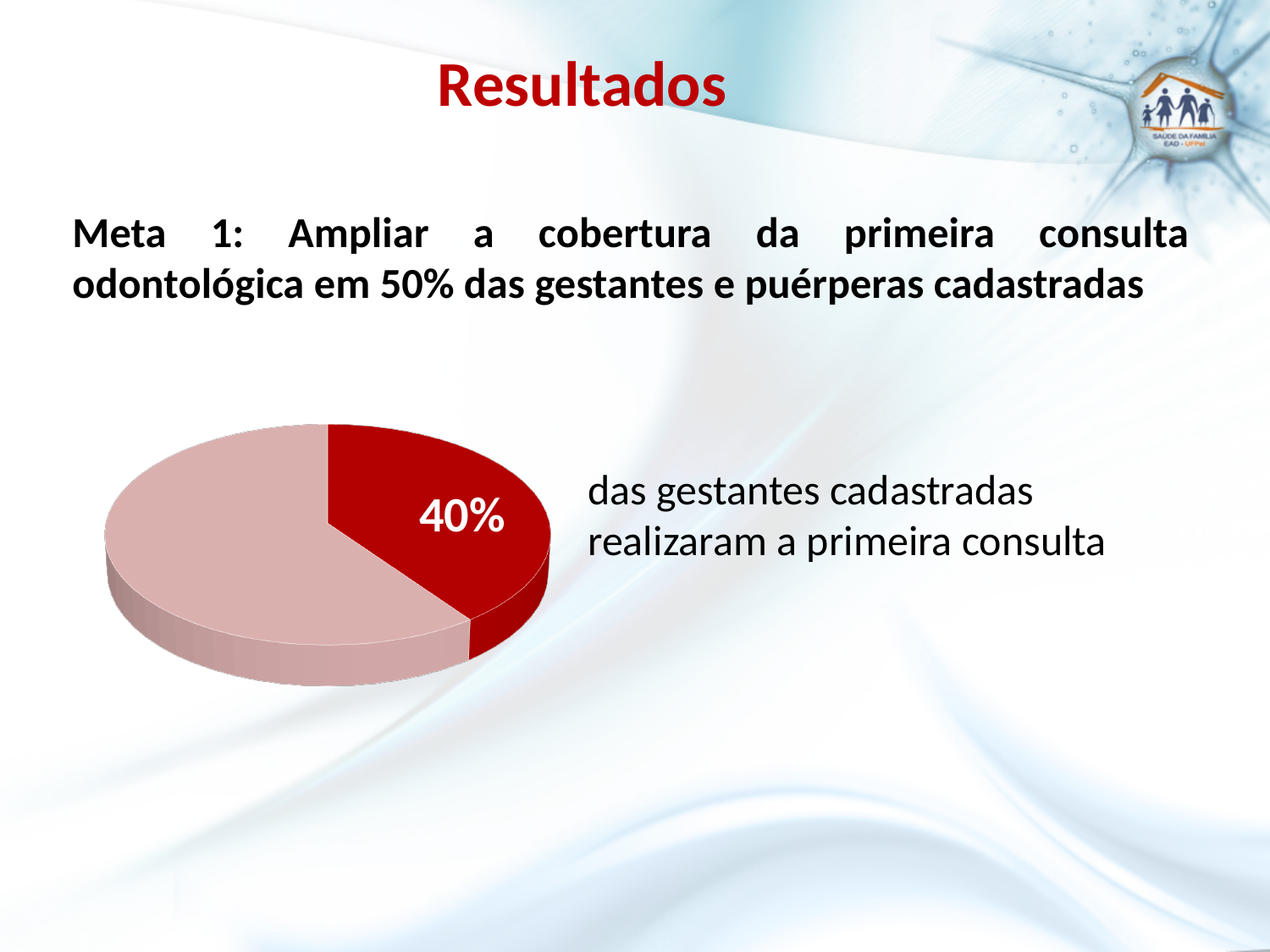
What percentage is printed on the dark red slice of the pie chart? 40% Which slice is the smallest in the pie chart? the dark red slice How many slices does the pie chart have? 2 According to the text next to the pie chart, what does the 40% slice represent? das gestantes cadastradas realizaram a primeira consulta Is the share of the dark red slice greater or less than 50%? less What kind of chart is shown on the slide? pie chart What colour is the slice that carries the 40% label? dark red What share of the pie does the dark red slice represent? 40% Which slice of the pie chart is larger, the dark red one or the light pink one? the light pink one Which slice is the largest in the pie chart? the light pink slice What share of the pie does the light pink slice represent? 60%